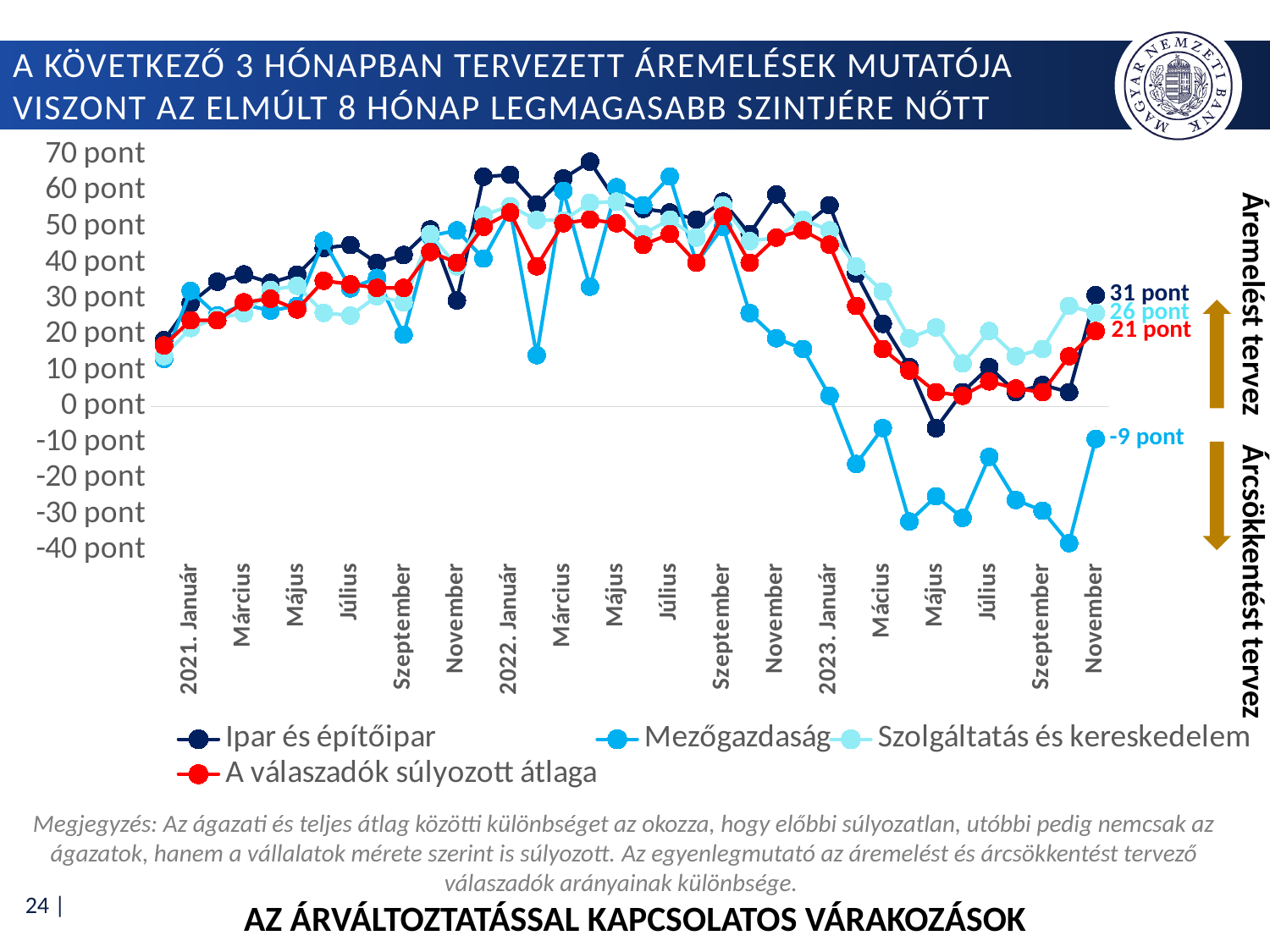
What kind of chart is shown on the slide? line chart What is the value for Ipar és építőipar at the last point (November 2023)? 31 pont Is the value for Mezőgazdaság in October 2023 greater or less than -30 pont? less What is the value for Szolgáltatás és kereskedelem at the last point (November 2023)? 26 pont What is the value for Mezőgazdaság at the last point (November 2023)? -9 pont What is the difference between the November 2023 values of Ipar és építőipar and A válaszadók súlyozott átlaga? 10 pont Which series is drawn in red? A válaszadók súlyozott átlaga Which series has the lowest value at the last point (November 2023)? Mezőgazdaság What is the value for A válaszadók súlyozott átlaga at the last point (November 2023)? 21 pont How many series does the legend list? 4 Which series has the highest value at the last point (November 2023)? Ipar és építőipar Is the value for Ipar és építőipar in March 2022 greater or less than 60 pont? greater